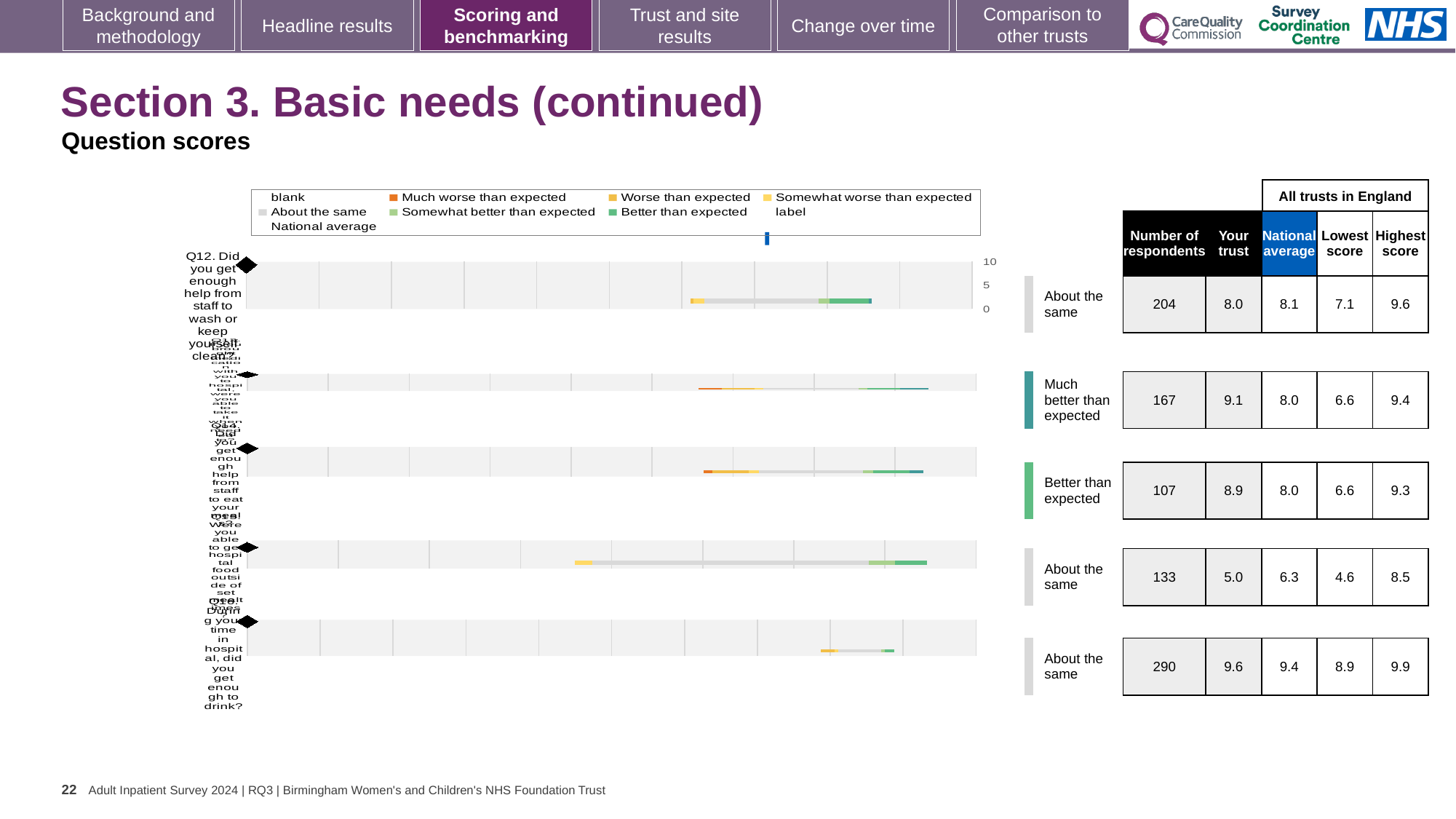
For the fourth row, is the 'Your trust' score higher or lower than the national average? lower How many question rows are plotted in the chart? 5 What is the 'Your trust' score for Q12 (help from staff to wash or keep yourself clean)? 8.0 What kind of chart is shown on the slide? bar chart What benchmark category is shown for the second row? Much better than expected For the second row, what is the difference between the 'Your trust' score and the national average? 1.1 What is the lowest score across all trusts in England for Q12 (help to wash or keep yourself clean)? 7.1 How many respondents are listed for the bottom row (did you get enough to drink)? 290 Which question row has the highest 'Your trust' score? During your time in hospital, did you get enough to drink? (bottom row) How many of the question rows are rated 'About the same'? 3 What is the highest score across all trusts in England for Q14 (help from staff to eat your meals)? 9.3 Which question row has the lowest 'Your trust' score? the fourth row (hospital food outside of set mealtimes)